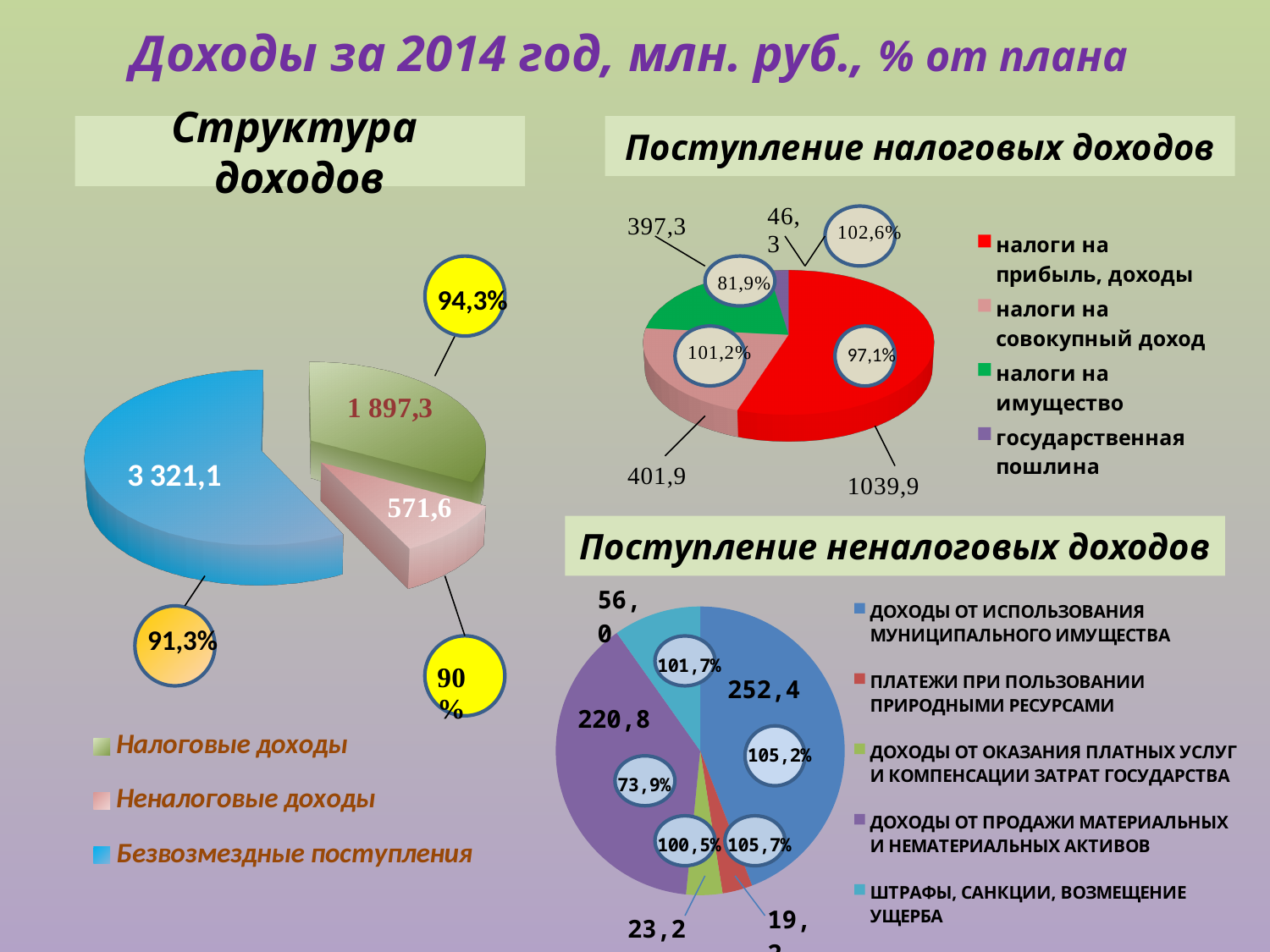
In the 'Поступление налоговых доходов' chart, what percent of plan is shown for налоги на имущество? 81,9% In the 'Поступление неналоговых доходов' chart, what is the value for доходы от продажи материальных и нематериальных активов? 220,8 What type of chart is used for 'Структура доходов'? Pie chart In the 'Поступление неналоговых доходов' chart, how many categories does the legend list? 5 In the 'Структура доходов' chart, which category has the largest value? Безвозмездные поступления In the 'Структура доходов' chart, what is the difference between Налоговые доходы and Неналоговые доходы? 1 325,7 In the 'Поступление налоговых доходов' chart, which category has the smallest value? государственная пошлина In the 'Поступление налоговых доходов' chart, how many categories does the legend list? 4 In the 'Поступление неналоговых доходов' chart, which is larger: доходы от использования муниципального имущества or штрафы, санкции, возмещение ущерба? доходы от использования муниципального имущества In the 'Структура доходов' chart, what is the value for Неналоговые доходы? 571,6 In the 'Поступление налоговых доходов' chart, what is the value for налоги на прибыль, доходы? 1039,9 In the 'Структура доходов' chart, what is the value for Безвозмездные поступления? 3 321,1